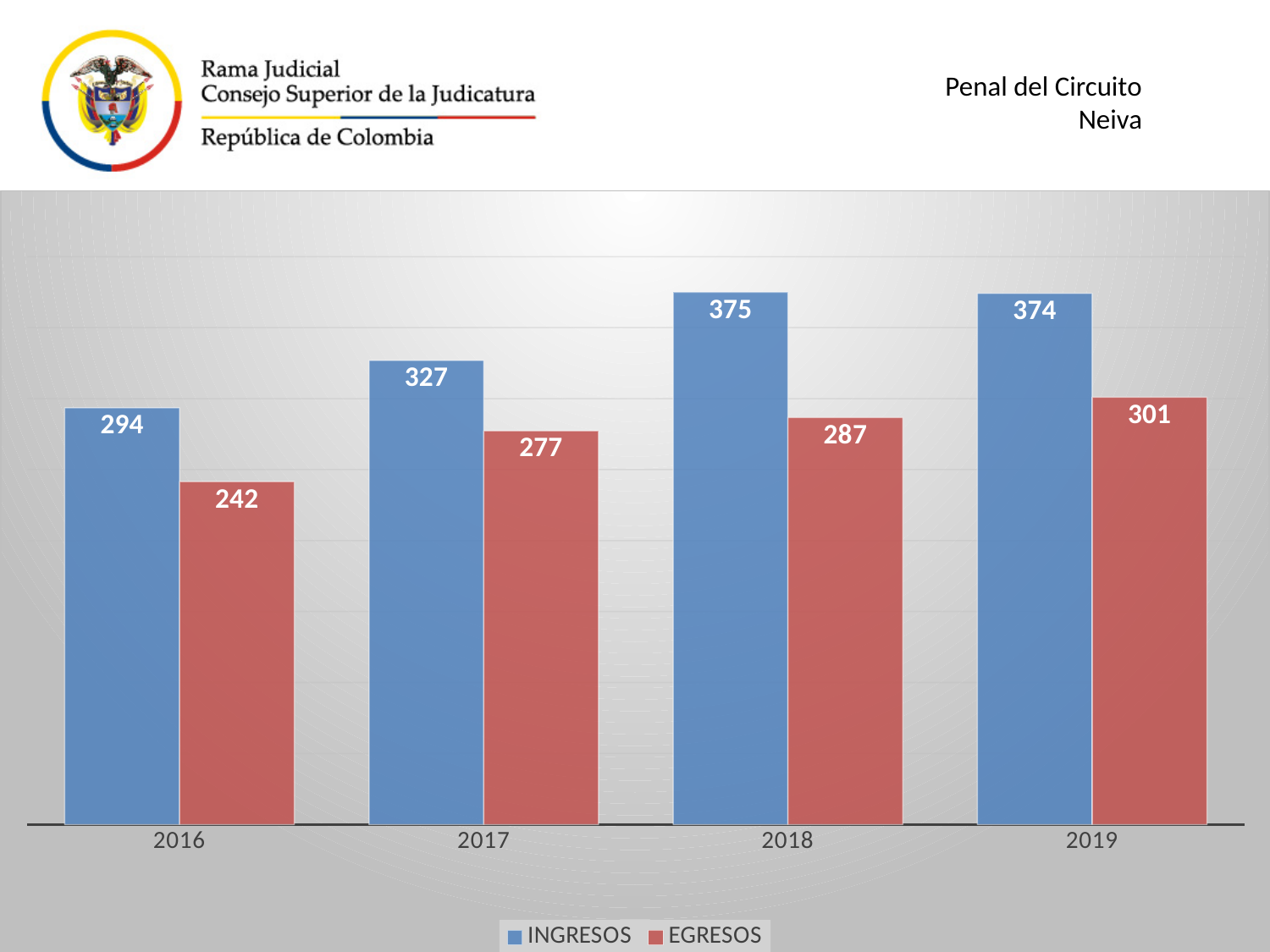
How many series does the legend list? 2 What is the difference between the EGRESOS values for 2019 and 2017? 24 What is the INGRESOS value for 2019? 374 In which year is the EGRESOS value highest? 2019 What is the EGRESOS value for 2016? 242 What is the difference between INGRESOS and EGRESOS in 2016? 52 Which is larger in 2018, INGRESOS or EGRESOS? INGRESOS How many years are shown on the x axis? 4 What is the EGRESOS value for 2018? 287 What is the INGRESOS value for 2017? 327 In which year is the INGRESOS value lowest? 2016 What kind of chart is shown on the slide? Bar chart